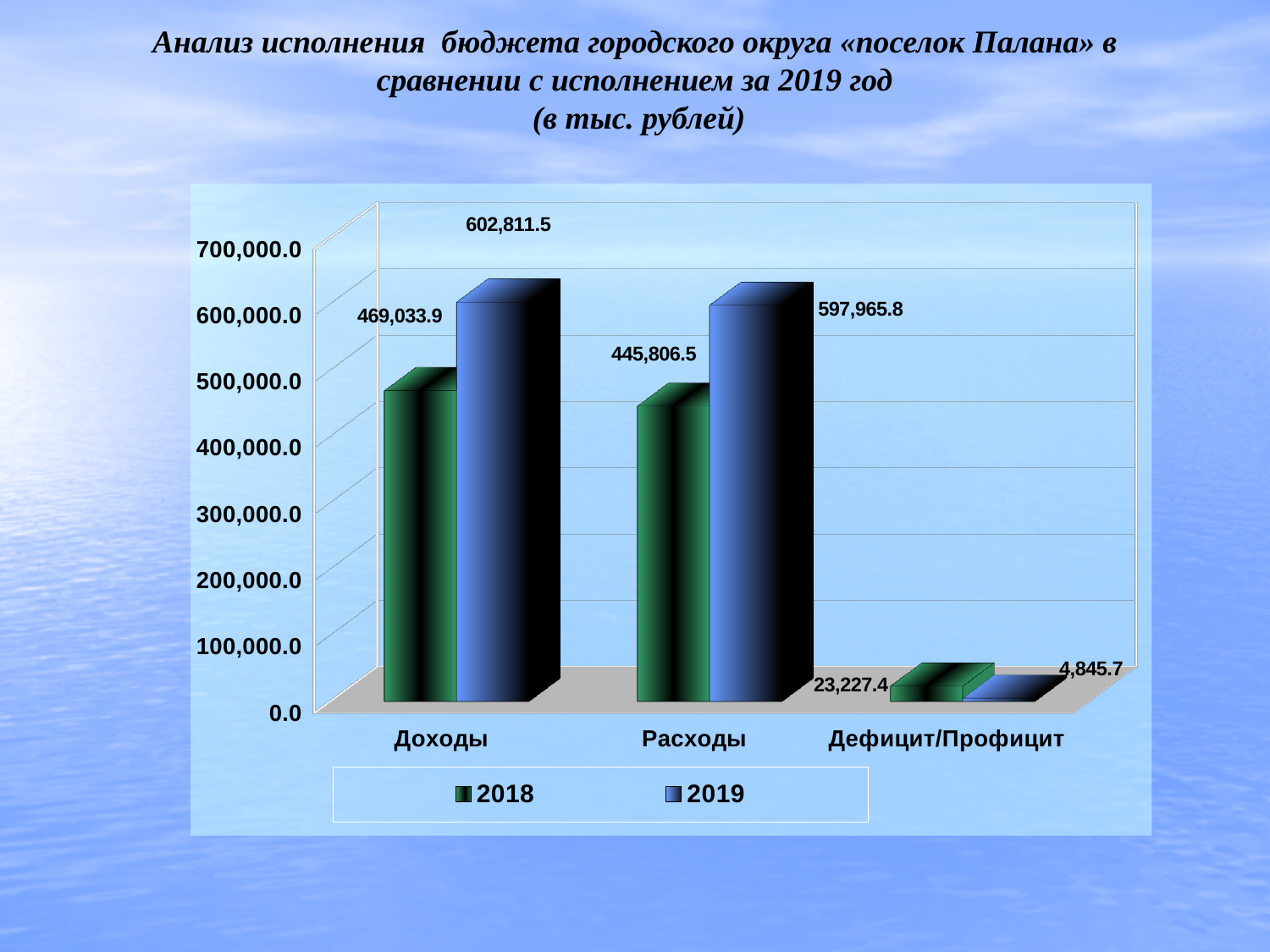
What kind of chart is shown on the slide? Bar chart How many categories are shown on the x axis? 3 What is the difference between the 2019 and 2018 values for Расходы? 152,159.3 Which category has the lowest value in the 2019 series? Дефицит/Профицит What is the value for Доходы in the 2018 series? 469,033.9 What is the value for Дефицит/Профицит in the 2018 series? 23,227.4 Which category has the highest value in the 2018 series? Доходы What is the difference between the 2019 and 2018 values for Доходы? 133,777.6 What is the value for Доходы in the 2019 series? 602,811.5 Which is larger for Дефицит/Профицит: the 2018 value or the 2019 value? 2018 How many series does the legend list? 2 What is the value for Расходы in the 2019 series? 597,965.8